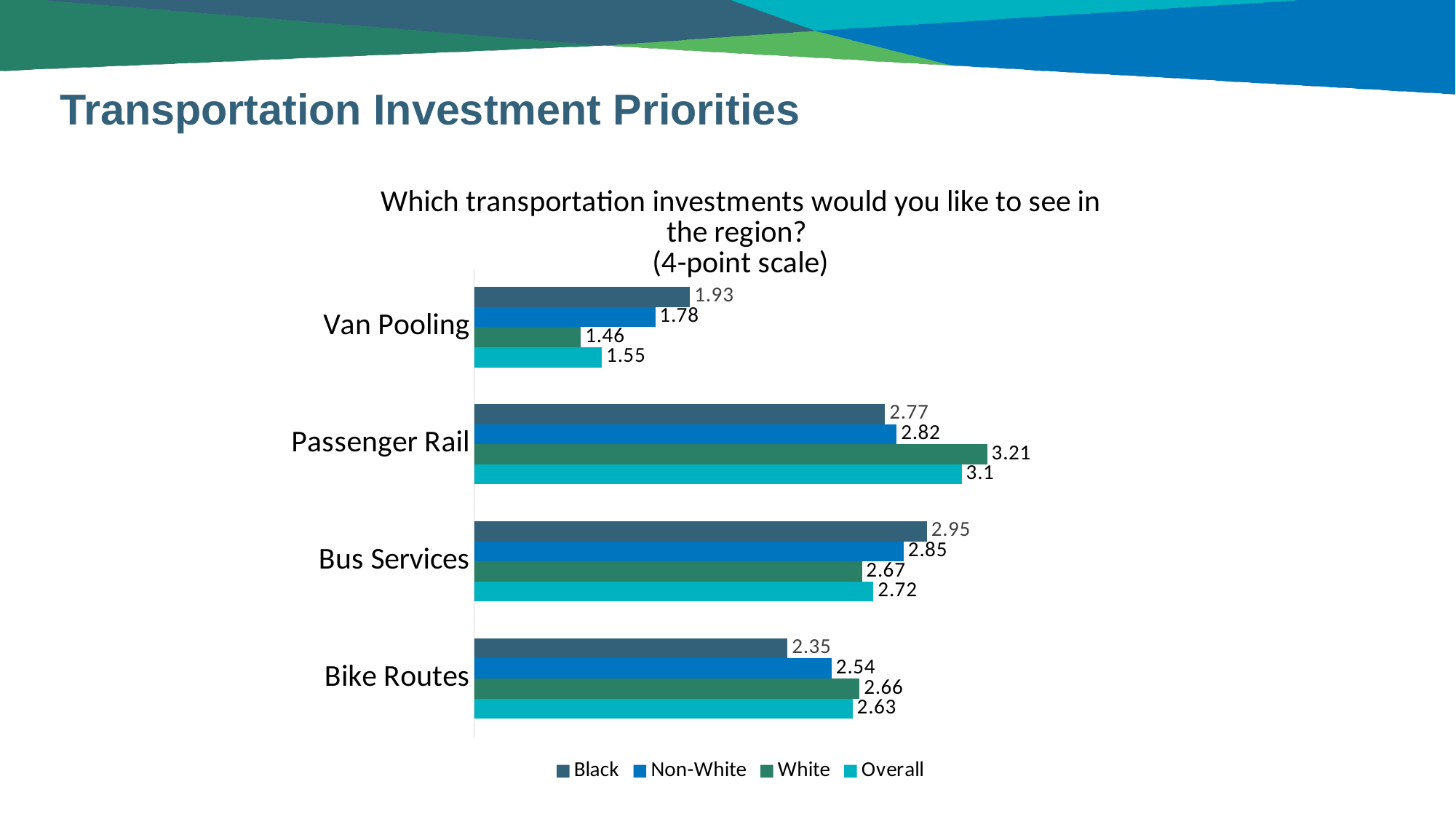
What kind of chart is shown on the slide? Bar chart What is the difference between the White and Black values for Passenger Rail? 0.44 Which is larger for Bike Routes, the Black value or the White value? White Which series is shown in the darkest blue colour in the legend? Black How many categories are shown on the chart? 4 Which category has the lowest Overall value? Van Pooling Which category has the highest White value? Passenger Rail What is the Overall value for Passenger Rail? 3.1 What is the Non-White value for Bike Routes? 2.54 How many series does the legend list? 4 What is the Black value for Bus Services? 2.95 What is the White value for Van Pooling? 1.46